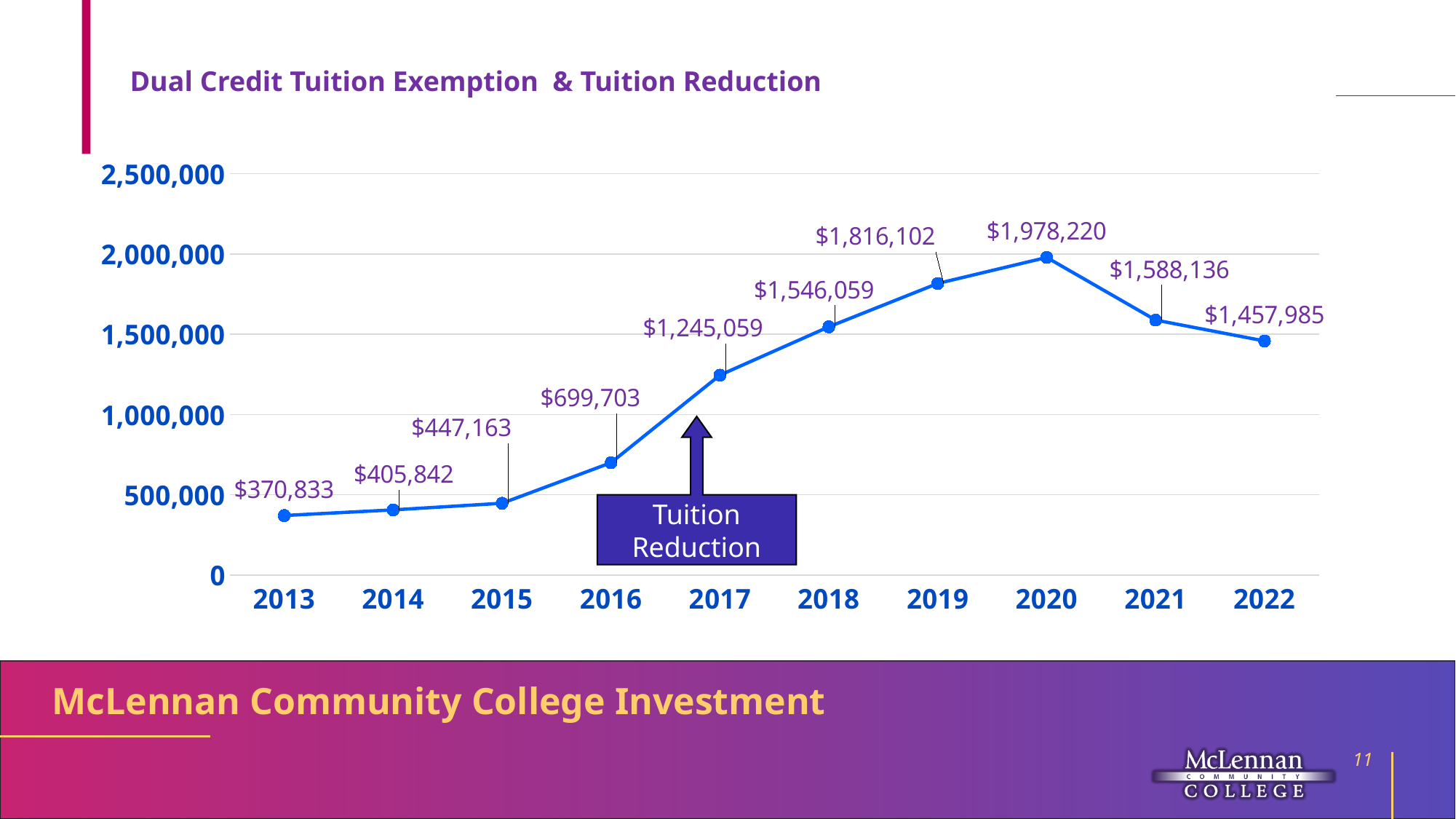
Which year has the highest value? 2020 What is the difference between the values for 2020 and 2013? $1,607,387 What kind of chart is shown on the slide? line chart What is the difference between the values for 2021 and 2022? $130,151 Which is larger, the value for 2019 or the value for 2021? 2019 What is the value for 2020? $1,978,220 Which year has the lowest value? 2013 What is the value for 2013? $370,833 Is the value for 2018 greater or less than 1,500,000? greater How many years are plotted on the chart? 10 Do the values rise or fall from 2013 to 2020? rise What is the value for 2017? $1,245,059